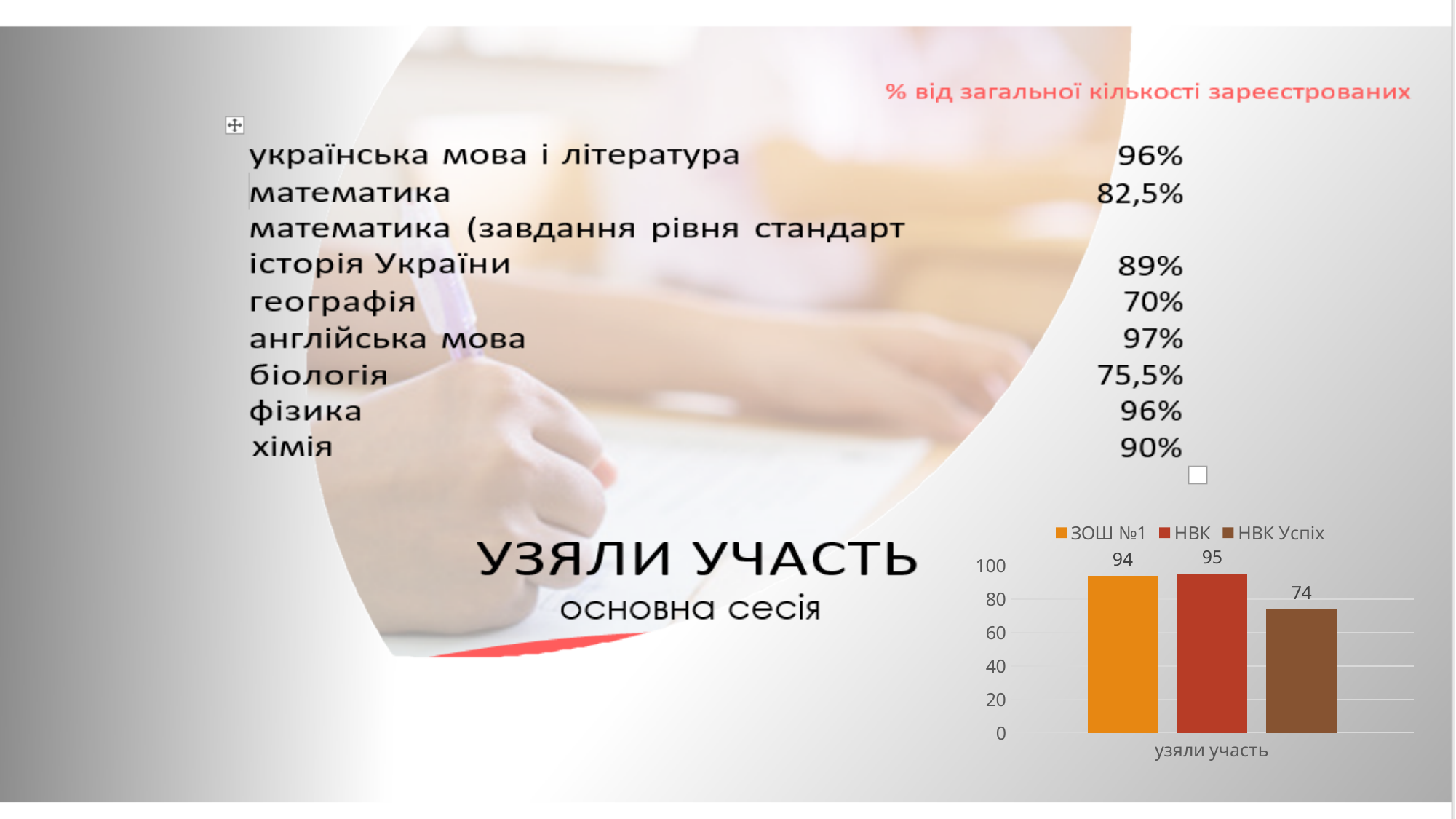
What type of chart is shown on the slide? bar chart Which is larger, the value for ЗОШ №1 or the value for НВК Успіх? ЗОШ №1 Which series has the lowest value in the chart? НВК Успіх What is the difference between the values for НВК and НВК Успіх? 21 What is the category label shown on the x axis of the chart? узяли участь What is the value for ЗОШ №1 in the chart? 94 How many series does the chart legend list? 3 What is the difference between the values for ЗОШ №1 and НВК Успіх? 20 What is the value for НВК Успіх in the chart? 74 Is the value for НВК Успіх greater or less than 80? less What is the value for НВК in the chart? 95 What colour is the bar for НВК Успіх in the chart? brown